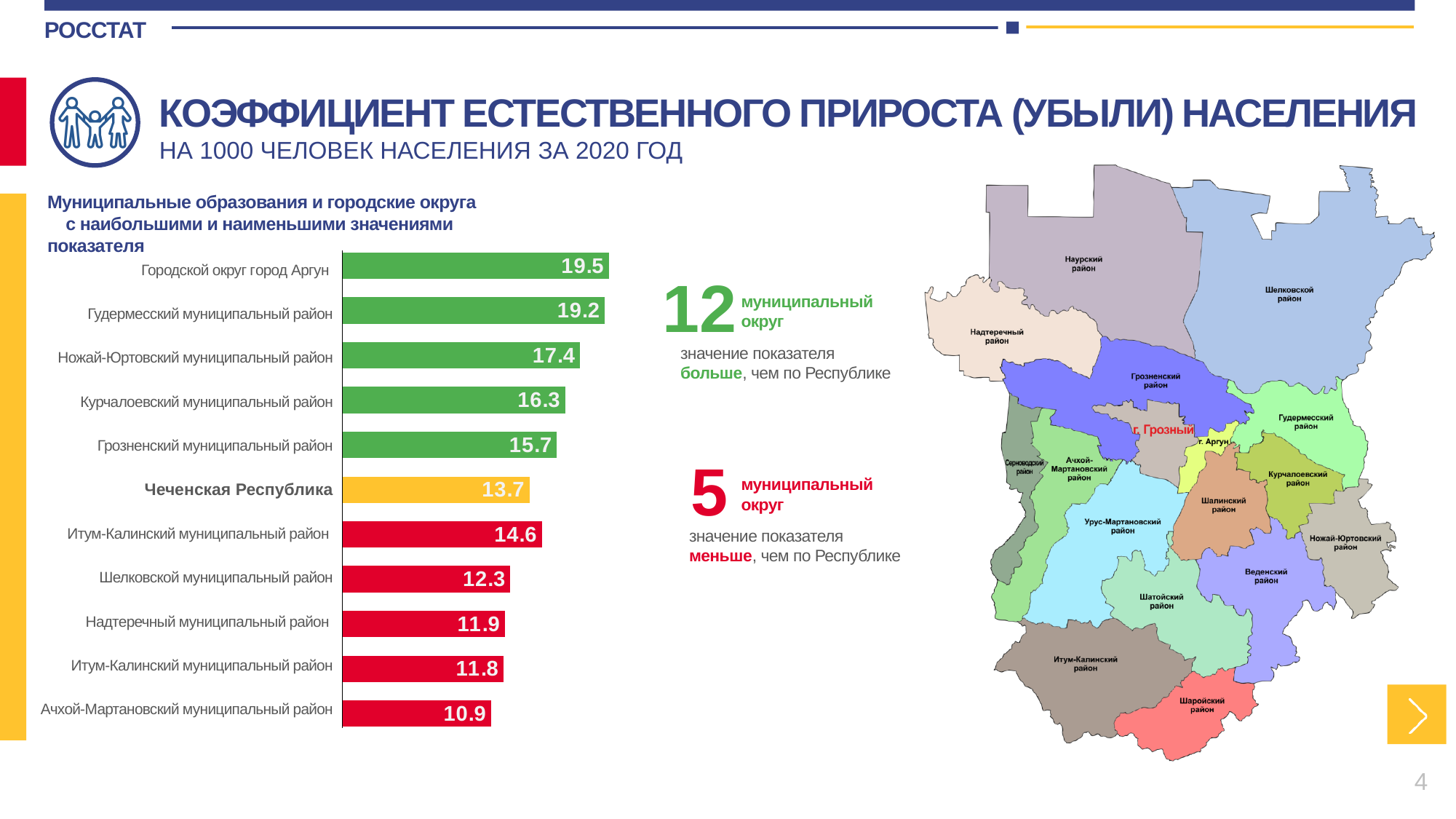
Which category has the lowest value? Ачхой-Мартановский муниципальный район Which is larger: the value for Грозненский муниципальный район or Надтеречный муниципальный район? Грозненский муниципальный район What is the difference between the values for Городской округ город Аргун and Ачхой-Мартановский муниципальный район? 8.6 What colour is the bar for Чеченская Республика? yellow What is the value for Городской округ город Аргун? 19.5 How many bars are shown in the chart? 11 What kind of chart is shown on the slide? bar chart Which category has the highest value? Городской округ город Аргун What is the value for Чеченская Республика? 13.7 What is the difference between the values for Гудермесский муниципальный район and Ножай-Юртовский муниципальный район? 1.8 What is the value for Курчалоевский муниципальный район? 16.3 What is the value for Шелковской муниципальный район? 12.3